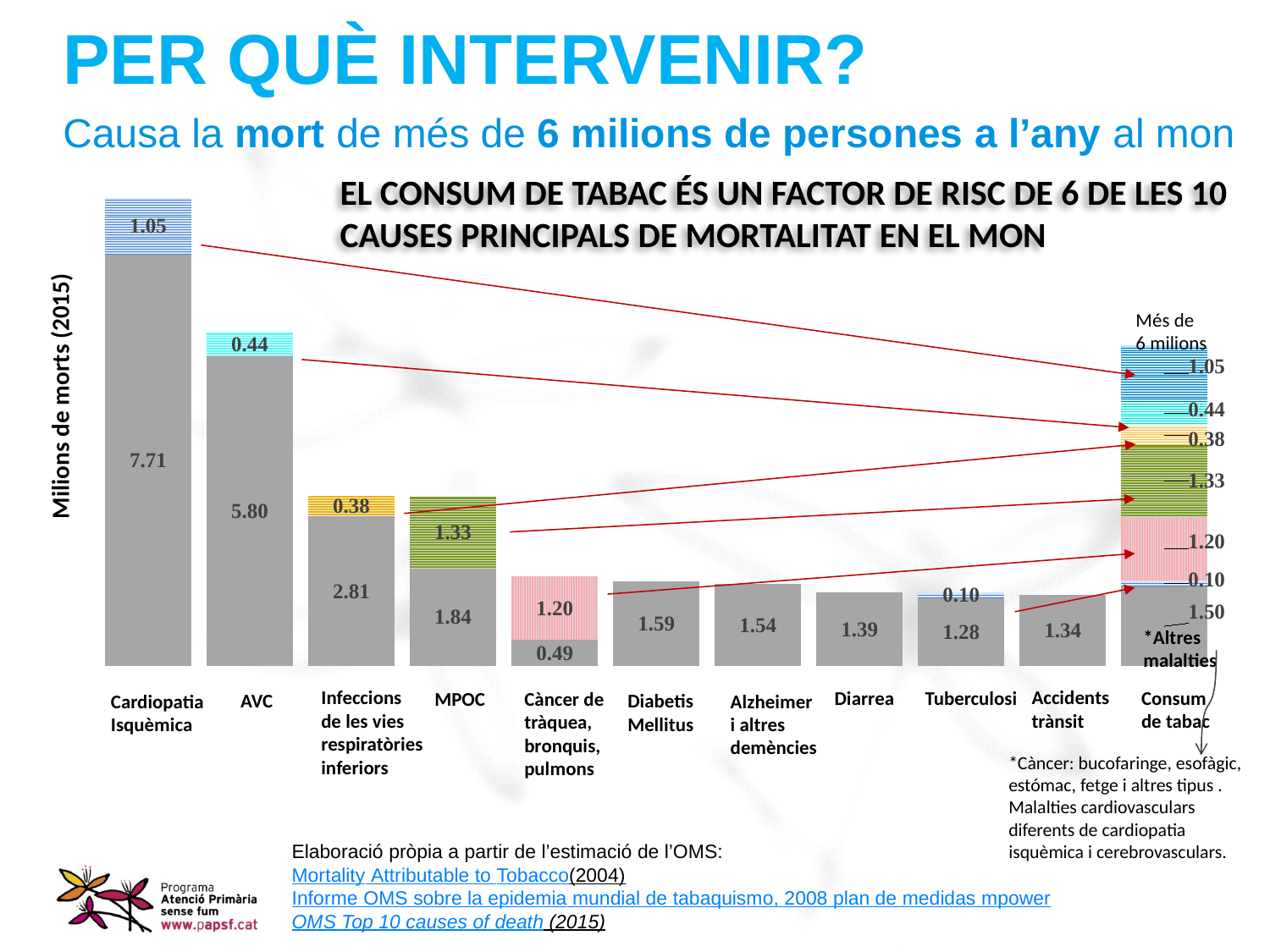
What is the value of the bottom segment labelled *Altres malalties in the Consum de tabac bar? 1.50 What is the value of the grey (non-tobacco) segment for Cardiopatia Isquèmica? 7.71 What is the difference between the grey segment of Cardiopatia Isquèmica (7.71) and the grey segment of AVC (5.80)? 1.91 What is the label of the vertical axis? Milions de morts (2015) What is the value shown for Diabetis Mellitus? 1.59 What is the value of the small blue segment on the Tuberculosi bar? 0.10 What is the total of the Cardiopatia Isquèmica bar (7.71 + 1.05)? 8.76 What is the value of the green striped segment on the MPOC bar? 1.33 What is the total of the Càncer de tràquea, bronquis, pulmons bar (0.49 + 1.20)? 1.69 Which cause of death has the tallest bar? Cardiopatia Isquèmica What is the value of the tobacco-attributable segment on top of the AVC bar? 0.44 Which is larger, the value for Alzheimer i altres demències or the grey value for Tuberculosi? Alzheimer i altres demències